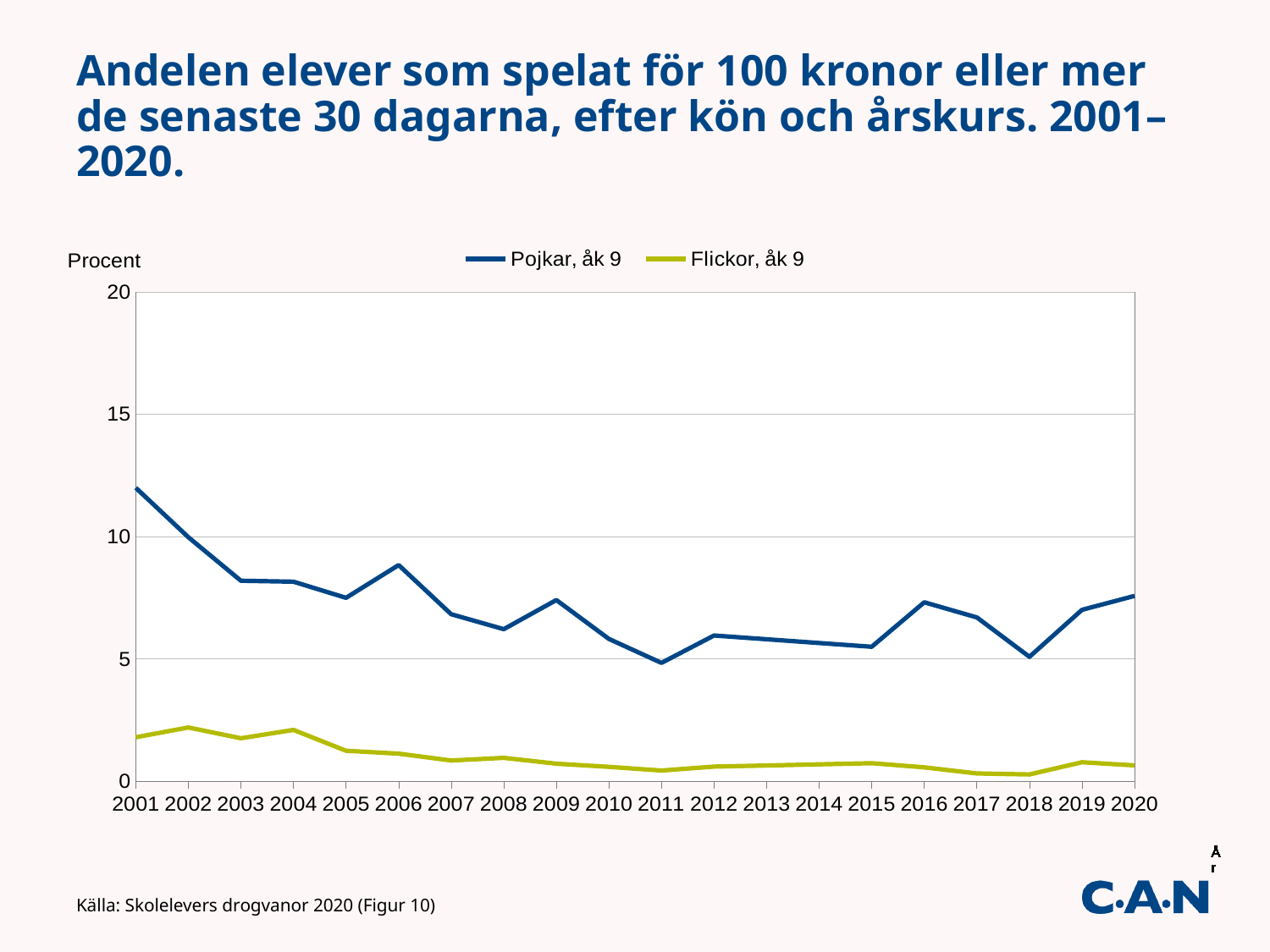
Is the value for Pojkar, åk 9 in 2001 greater or less than 10? greater Does the value for Pojkar, åk 9 rise or fall between 2001 and 2011? fall Is the value for Flickor, åk 9 in 2001 greater or less than 5? less Is the value for Pojkar, åk 9 in 2020 greater or less than 5? greater How many series does the legend list? 2 In 2010, which series has the higher value, Pojkar, åk 9 or Flickor, åk 9? Pojkar, åk 9 What kind of chart is shown on the slide? line chart How many years are plotted along the x axis? 20 What label is shown on the vertical axis? Procent Which series is drawn in dark blue? Pojkar, åk 9 In which year is the value for Pojkar, åk 9 highest? 2001